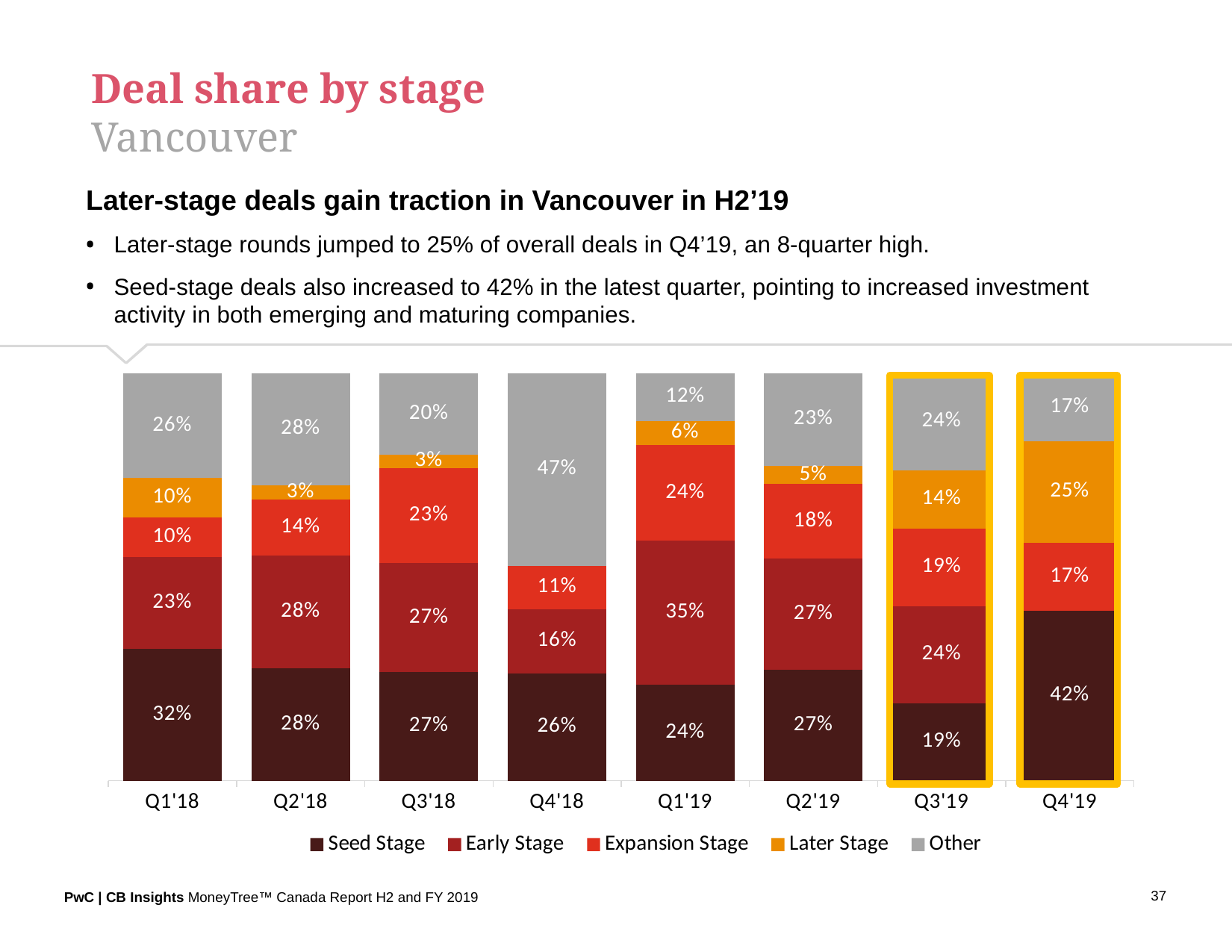
What is the Seed Stage share in Q4'19? 42% What is the Early Stage share in Q1'19? 35% How many series does the legend list? 5 What kind of chart is shown on the slide? Stacked bar chart How many quarters are shown on the x axis? 8 What is the difference between the Later Stage share in Q4'19 and in Q3'19? 11 percentage points Which is larger in Q2'19: the Expansion Stage share or the Other share? Other What is the Other share in Q4'18? 47% What is the Later Stage share in Q3'19? 14% Which two quarters are highlighted with a yellow outline? Q3'19 and Q4'19 In which quarter is the Seed Stage share highest? Q4'19 In which quarter is the Seed Stage share lowest? Q3'19